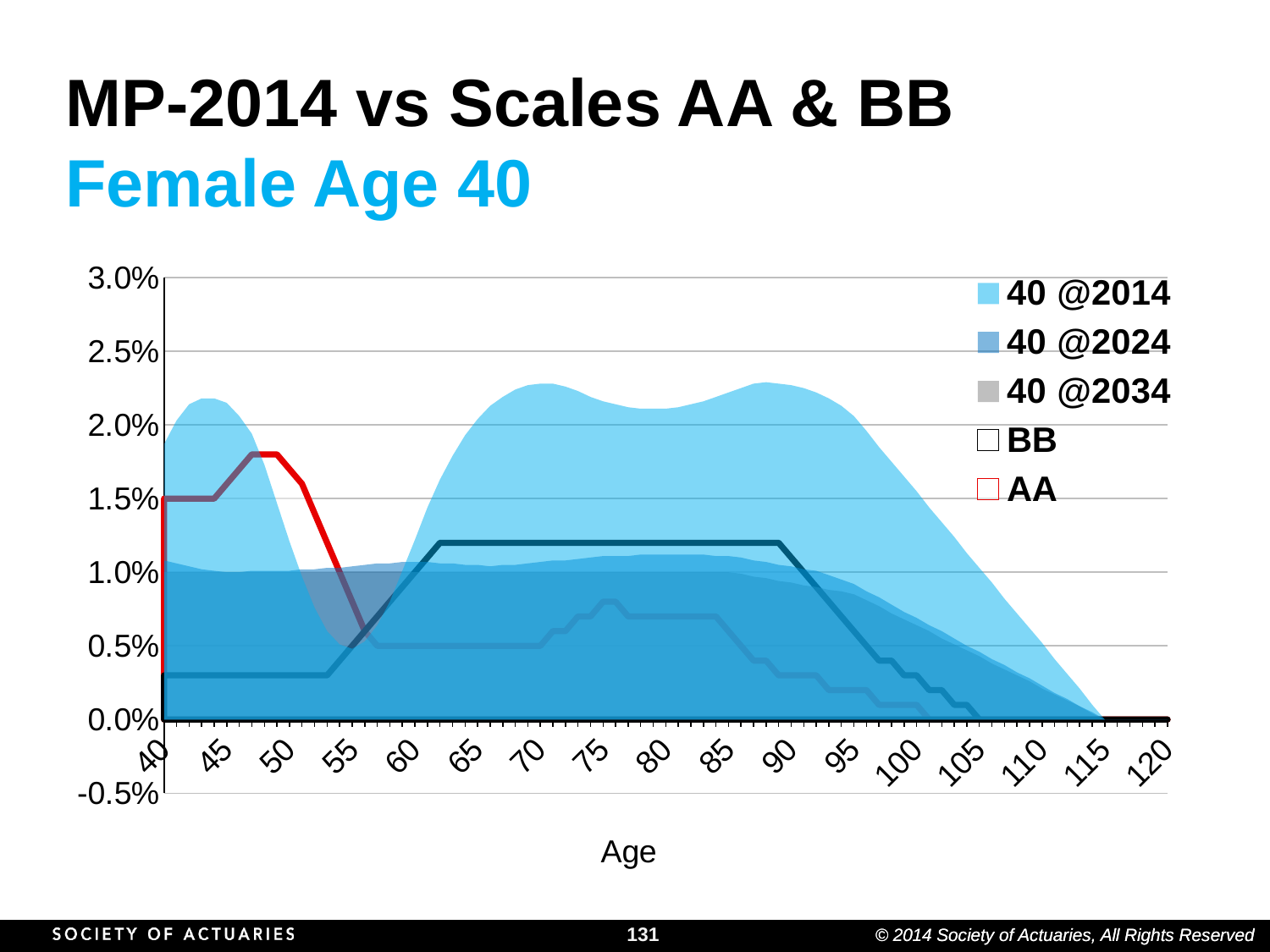
What is the title of the x axis? Age Is the value of the AA series at age 50 greater or less than 1.5%? greater Is the value of the 40 @2024 series at age 80 greater or less than 1.5%? less What kind of chart is shown on the slide? area chart At age 50, which series has the larger value, AA or BB? AA Is the value of the 40 @2014 series at age 70 greater or less than 2.0%? greater Does the 40 @2014 series rise or fall between age 95 and age 115? fall At age 70, which series has the larger value, 40 @2014 or 40 @2024? 40 @2014 Which series are listed in the legend? 40 @2014, 40 @2024, 40 @2034, BB, AA How many series does the legend list? 5